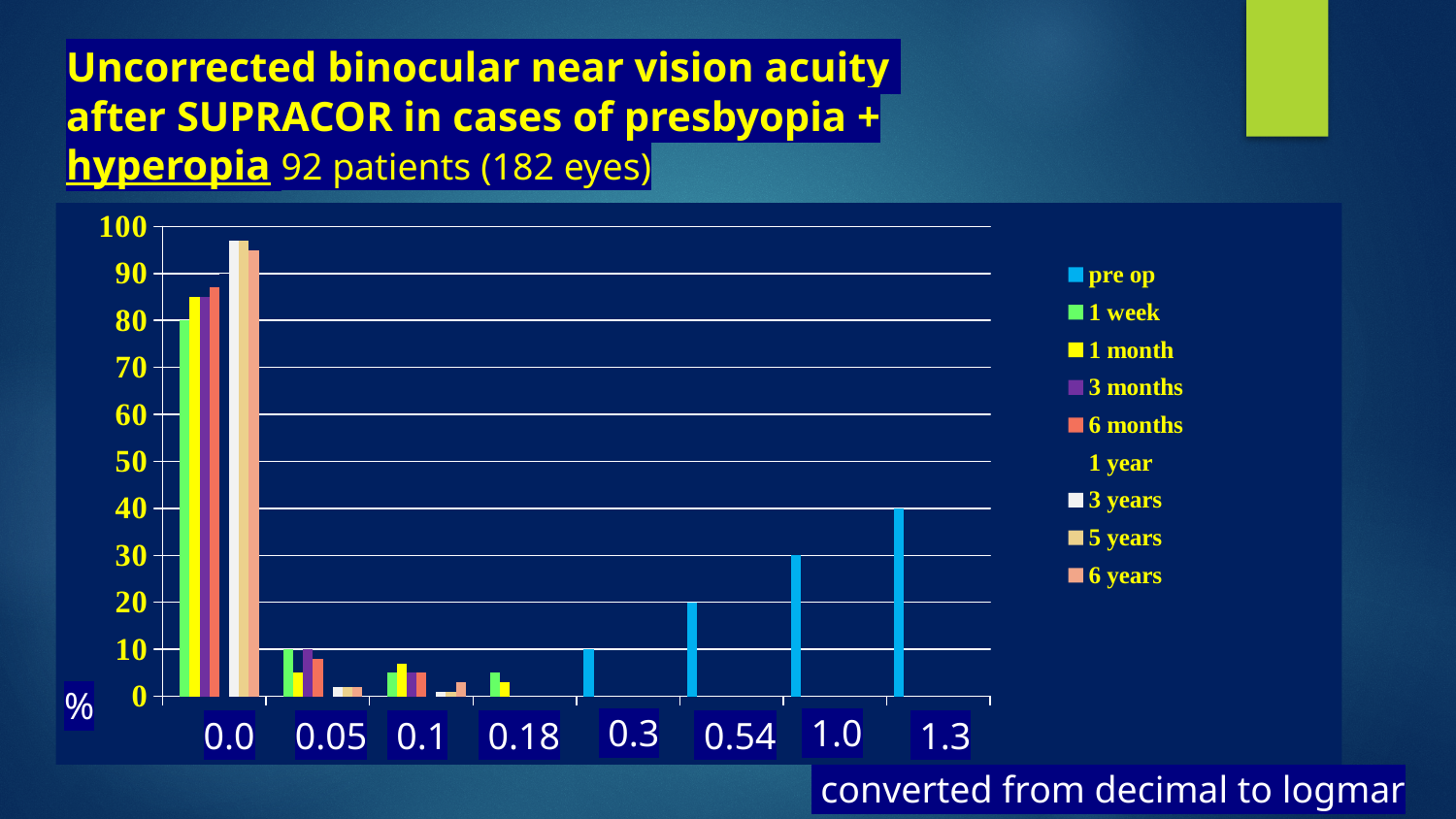
Is the value for the pre op series at category 1.3 greater or less than 30? greater At category 0.0, which is larger: the 3 years value or the 1 week value? 3 years Is the value for the 3 years series at category 0.0 greater or less than 90? greater How many categories are shown along the x axis of the chart? 8 At which category does the pre op series reach its highest value? 1.3 What kind of chart is shown on the slide? bar chart Is the value for the 1 week series at category 0.0 greater or less than 70? greater What unit label is shown next to the y axis of the chart? % Do the pre op values rise or fall along the x axis from category 0.3 to category 1.3? rise How many series does the chart's legend list? 9 Which is larger: the pre op value at category 1.3 or the pre op value at category 1.0? 1.3 What is the value for the pre op series at category 1.3? 40